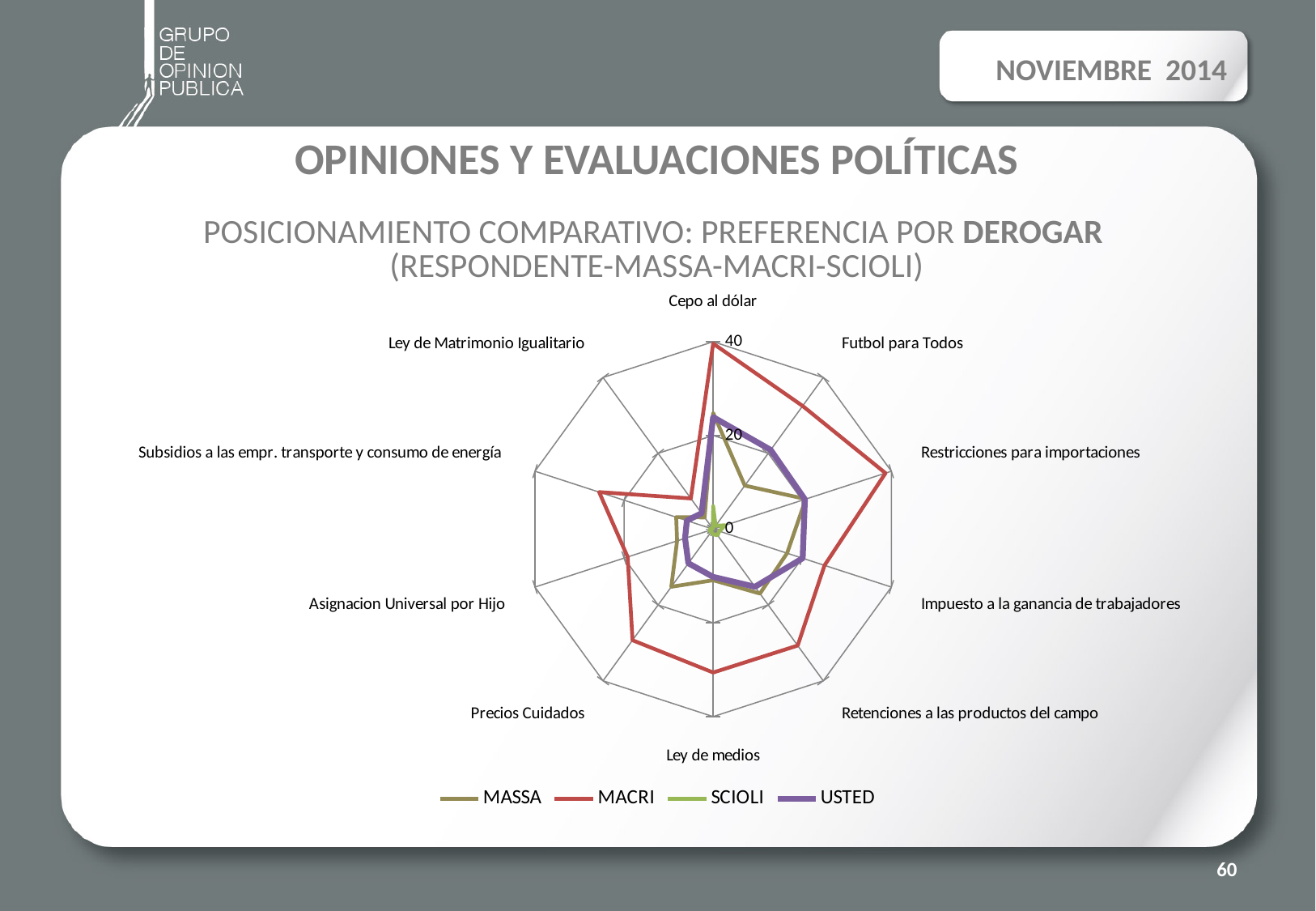
Is the MACRI value for Cepo al dólar greater or less than 20? greater Which series are listed in the legend? MASSA, MACRI, SCIOLI, USTED What is the highest value shown on the chart's axis scale? 40 How many categories (axes) does the radar chart have? 10 For Precios Cuidados, which series has the larger value, MACRI or MASSA? MACRI For which category is the MACRI value the lowest? Ley de Matrimonio Igualitario Is the MACRI value for Ley de Matrimonio Igualitario greater or less than 20? less How many series does the legend list? 4 Is the SCIOLI value for Cepo al dólar greater or less than 20? less For Cepo al dólar, which series has the larger value, MACRI or USTED? MACRI What kind of chart is shown on the slide? Radar chart